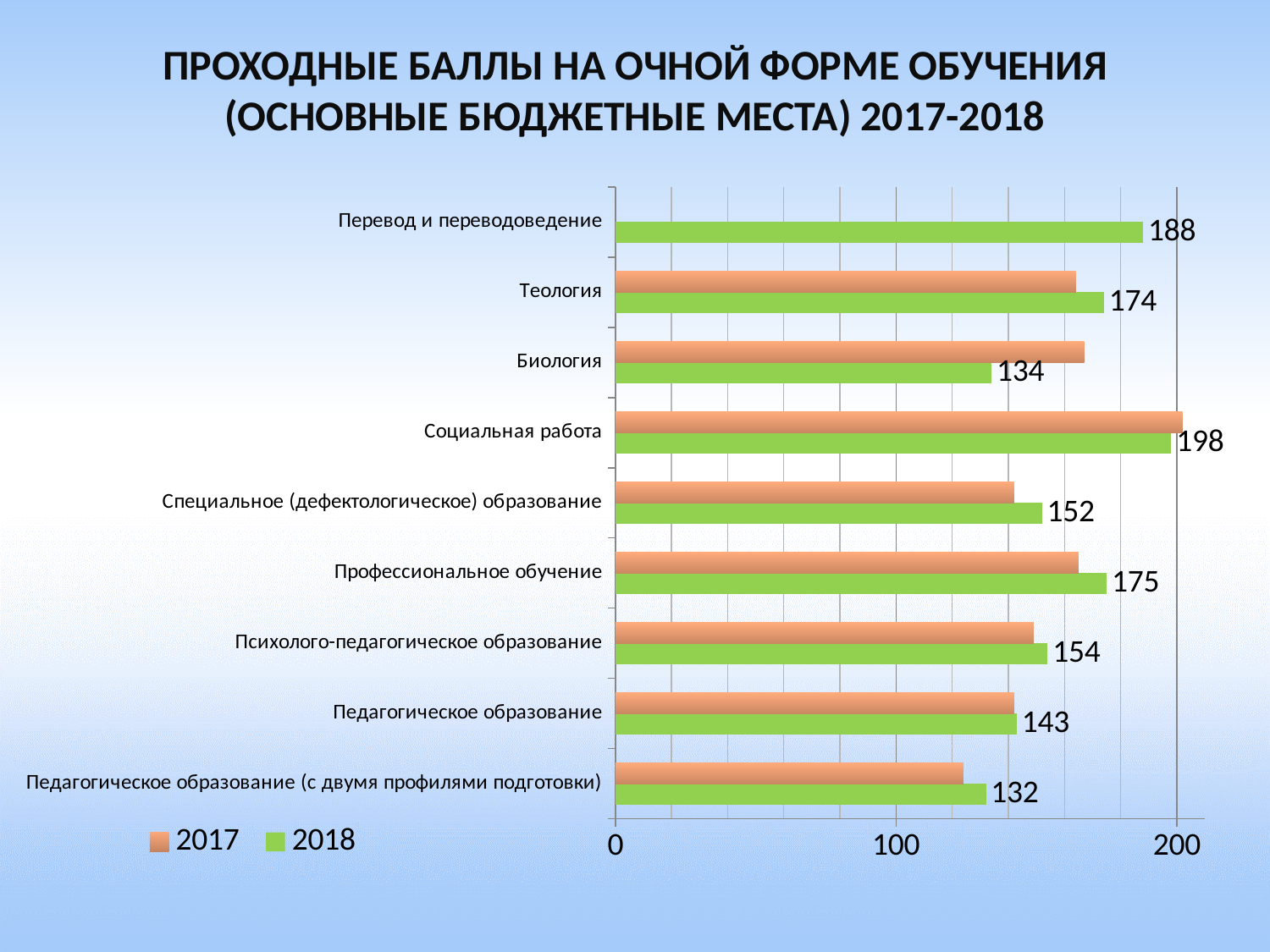
Which category has the highest 2018 value? Социальная работа What kind of chart is shown on the slide? bar chart What is the difference between the 2018 values for Перевод и переводоведение and Биология? 54 What is the 2018 value for Социальная работа? 198 How many categories are shown on the chart? 9 What is the 2018 value for Перевод и переводоведение? 188 What is the 2018 value for Биология? 134 How many series does the legend list? 2 Which category has the lowest 2018 value? Педагогическое образование (с двумя профилями подготовки) What is the 2018 value for Педагогическое образование? 143 Is the 2017 value for Педагогическое образование (с двумя профилями подготовки) greater or less than 100? greater For Биология, which series has the larger value, 2017 or 2018? 2017